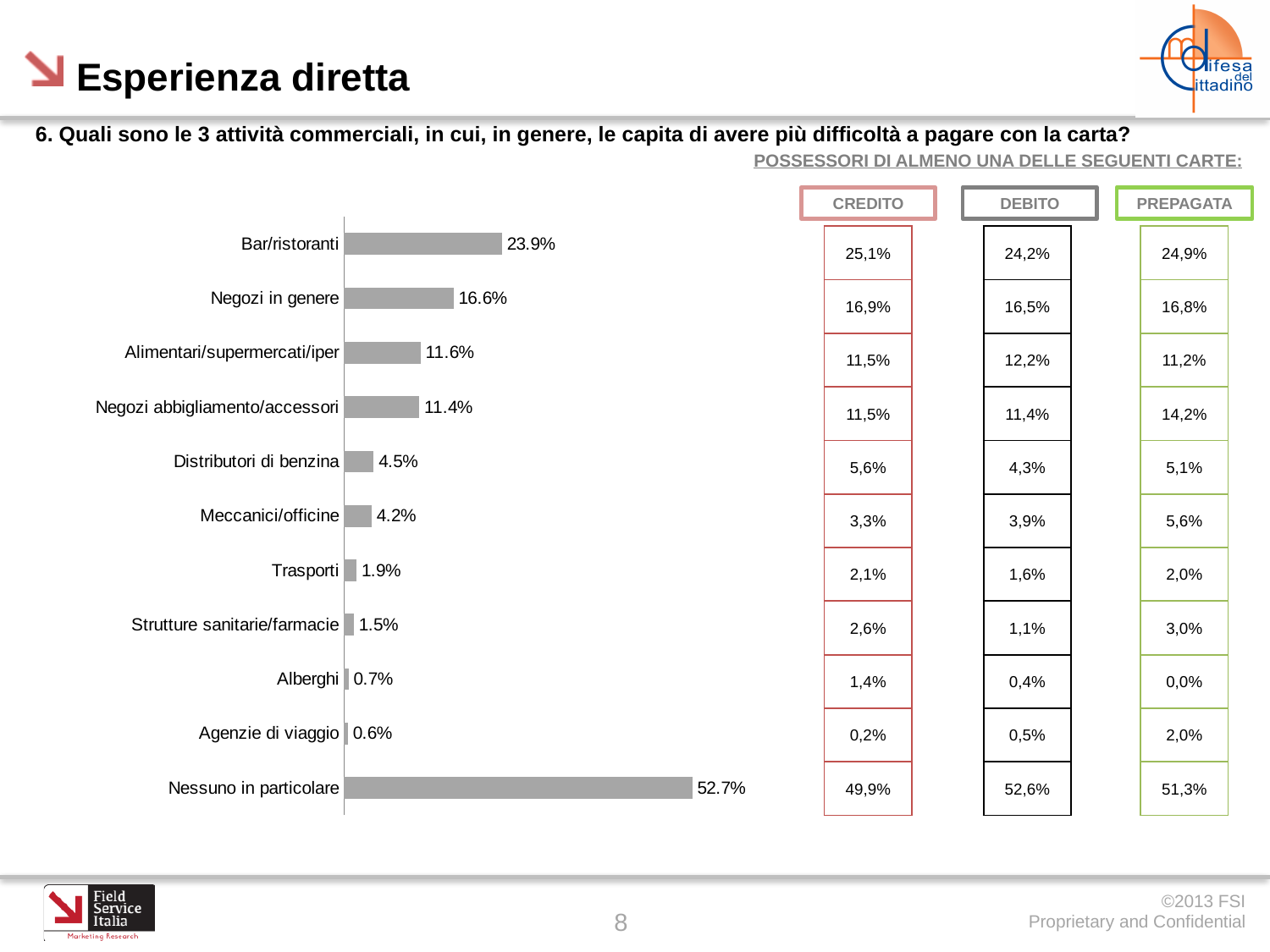
Which category has the lowest value in the bar chart? Agenzie di viaggio How many categories are shown in the bar chart? 11 What is the difference between the values for Bar/ristoranti and Negozi in genere in the bar chart? 7.3% What is the value for Negozi in genere in the bar chart? 16.6% What is the value for Agenzie di viaggio in the bar chart? 0.6% What is the value for Bar/ristoranti in the bar chart? 23.9% Which is larger in the bar chart: Meccanici/officine or Trasporti? Meccanici/officine What is the difference between the values for Trasporti and Strutture sanitarie/farmacie in the bar chart? 0.4% Which is larger in the bar chart: Alimentari/supermercati/iper or Negozi abbigliamento/accessori? Alimentari/supermercati/iper What kind of chart is shown on the slide? Bar chart What is the value for Distributori di benzina in the bar chart? 4.5% Which category has the highest value in the bar chart? Nessuno in particolare